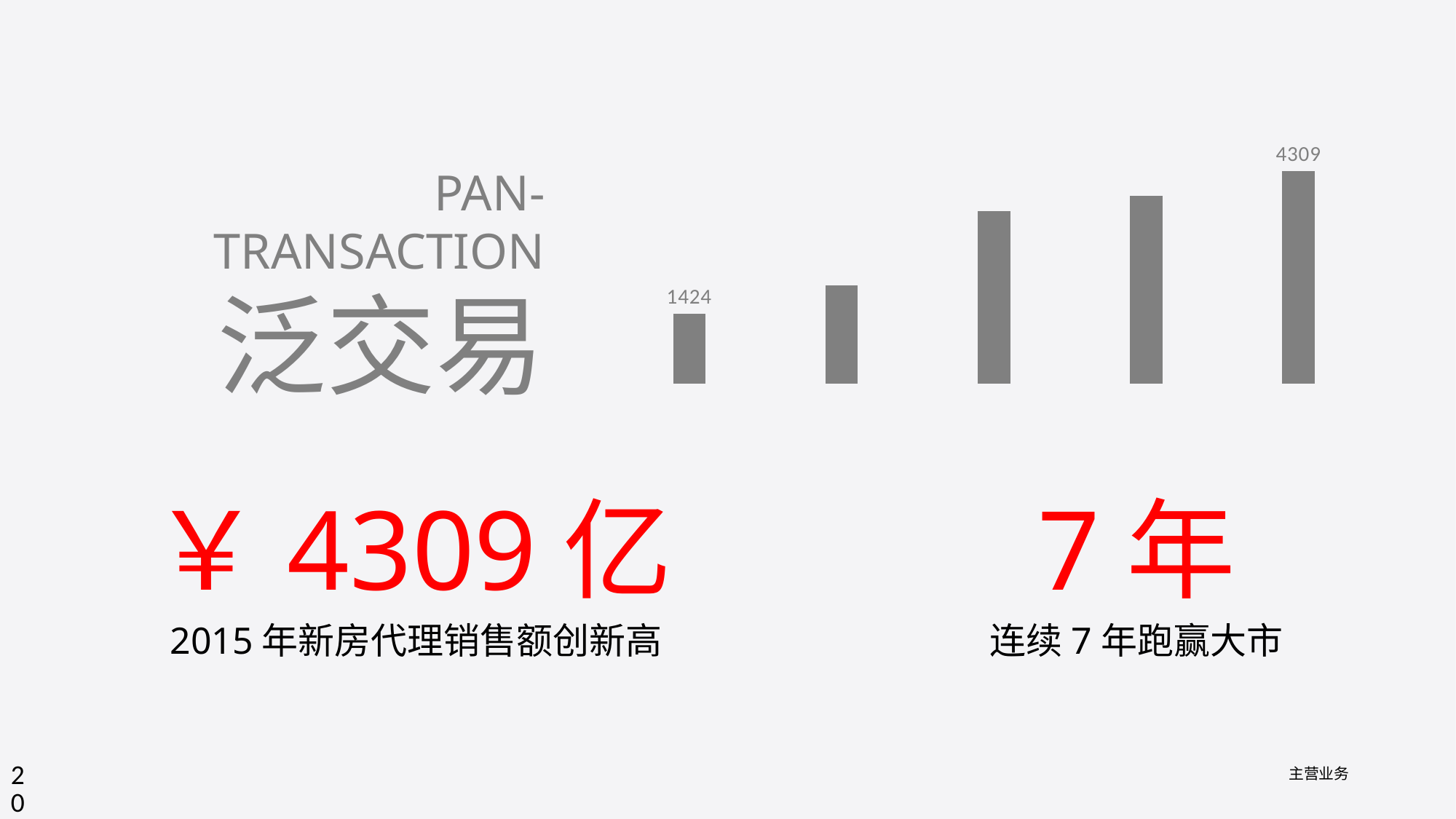
What value is labelled on the rightmost bar of the chart? 4309 Which bar in the chart is the shortest? the leftmost bar (1424) What is the difference between the rightmost bar's value and the leftmost bar's value? 2885 What kind of chart is shown on the slide? bar chart Which bar in the chart is the tallest? the rightmost bar (4309) What value is labelled on the leftmost bar of the chart? 1424 How many bars does the chart contain? 5 What colour are the bars in the chart? grey How many bars in the chart have a printed data label? 2 Do the bar values rise or fall from left to right across the chart? rise Which is larger, the value of the leftmost bar or the value of the rightmost bar? the rightmost bar